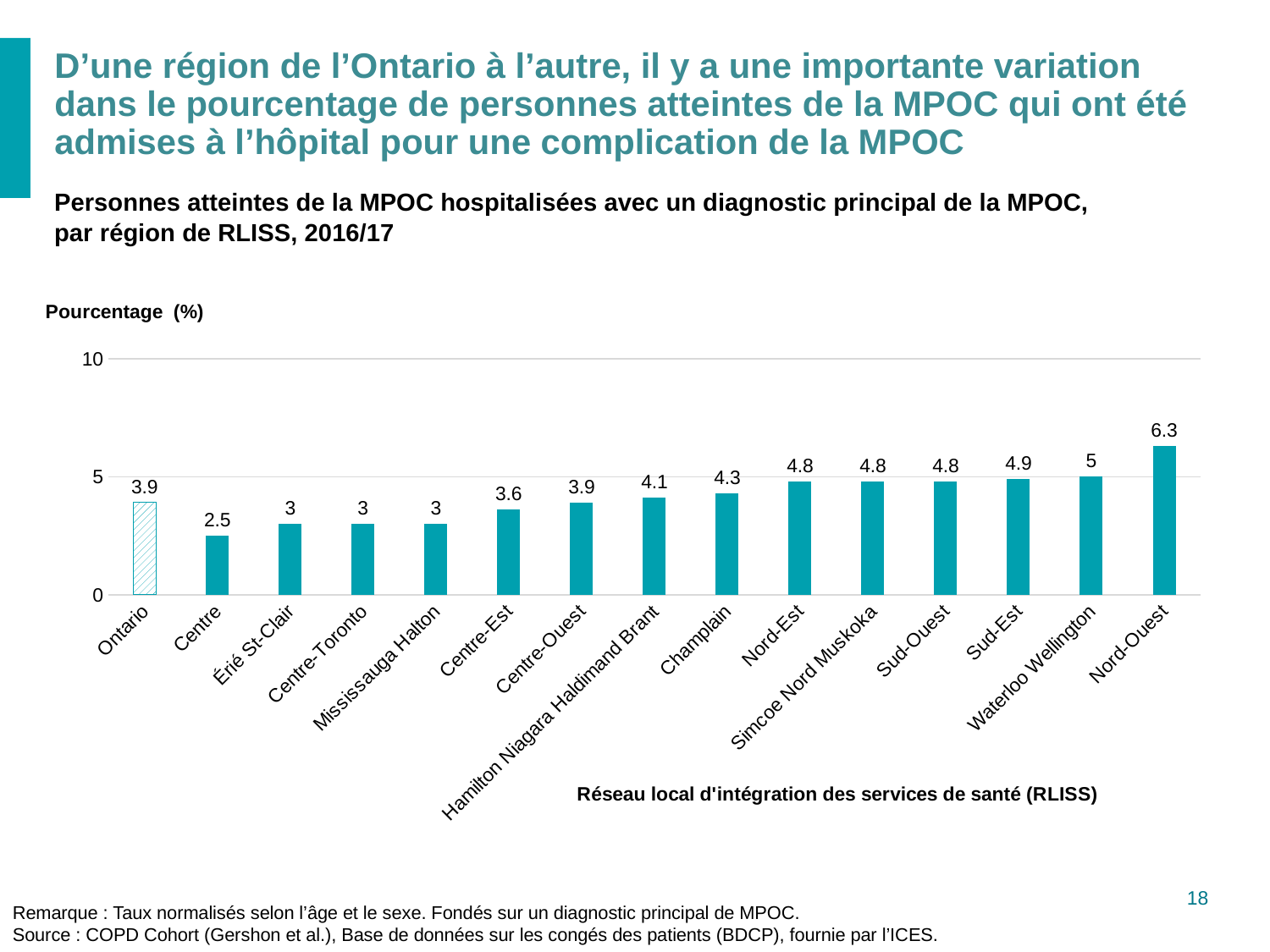
What is the value for Champlain? 4.3 What is the value for Ontario? 3.9 Is the value for Waterloo Wellington greater or less than 10? less How many categories are shown on the x axis? 15 Do the values generally rise or fall from Centre to Nord-Ouest along the x axis? rise What is the label of the y axis? Pourcentage (%) What is the value for Nord-Ouest? 6.3 Which is larger, the value for Centre-Est or the value for Sud-Est? Sud-Est Which region has the lowest value? Centre What is the difference between the values for Nord-Ouest and Centre? 3.8 Which region has the highest value? Nord-Ouest What kind of chart is this? bar chart